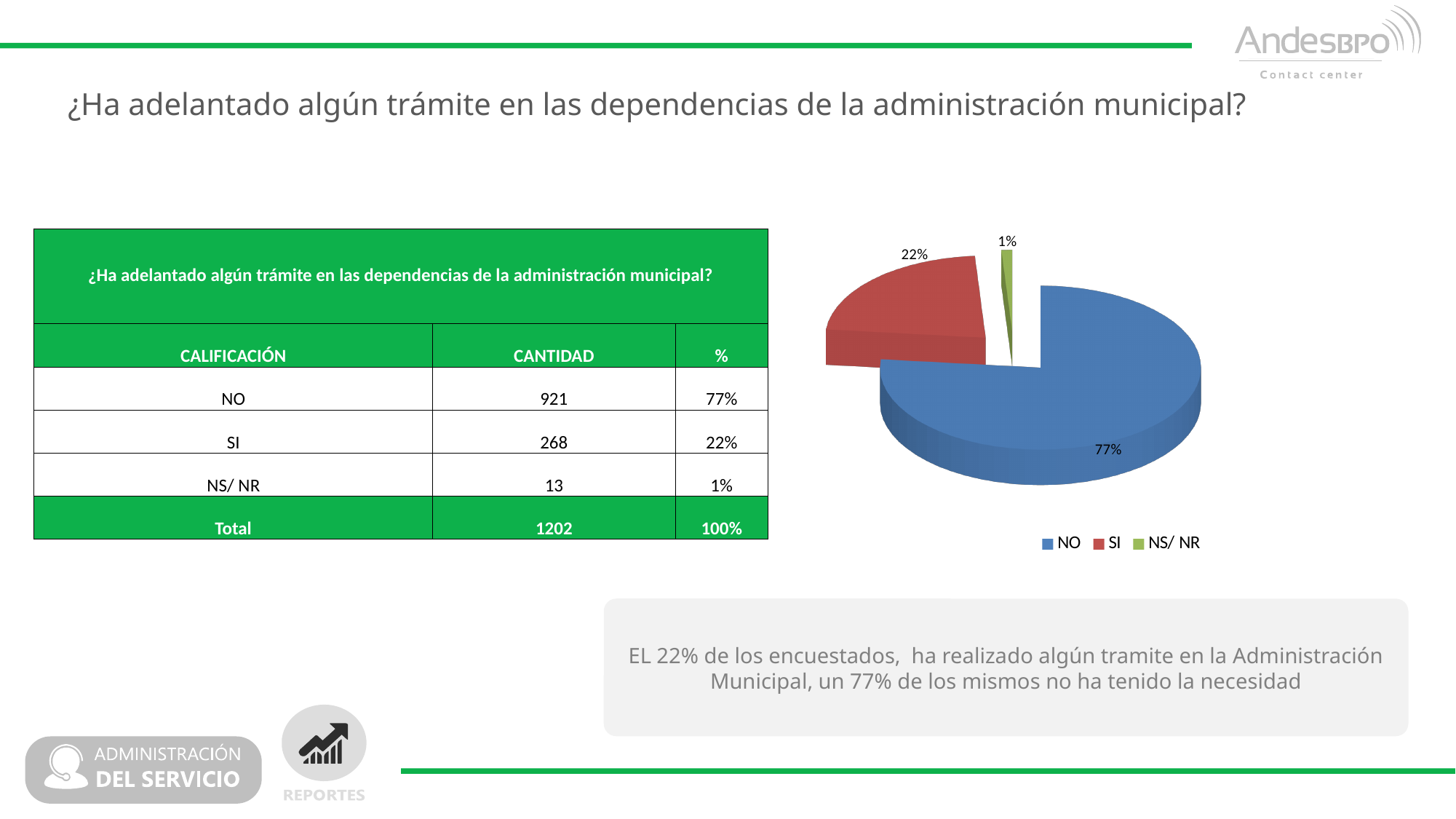
What share of the pie does the NS/ NR slice represent? 1% How many entries does the legend list? 3 Which category has the largest slice of the pie? NO Which category has the smallest slice of the pie? NS/ NR What share of the pie does the SI slice represent? 22% What is the difference in percentage points between the NO slice and the SI slice? 55% What colour is the NO slice in the pie chart? blue What colour is the SI slice in the pie chart? red How many slices does the pie chart have? 3 What share of the pie does the NO slice represent? 77% What kind of chart is shown on the slide? pie chart Which slice is larger, SI or NS/ NR? SI